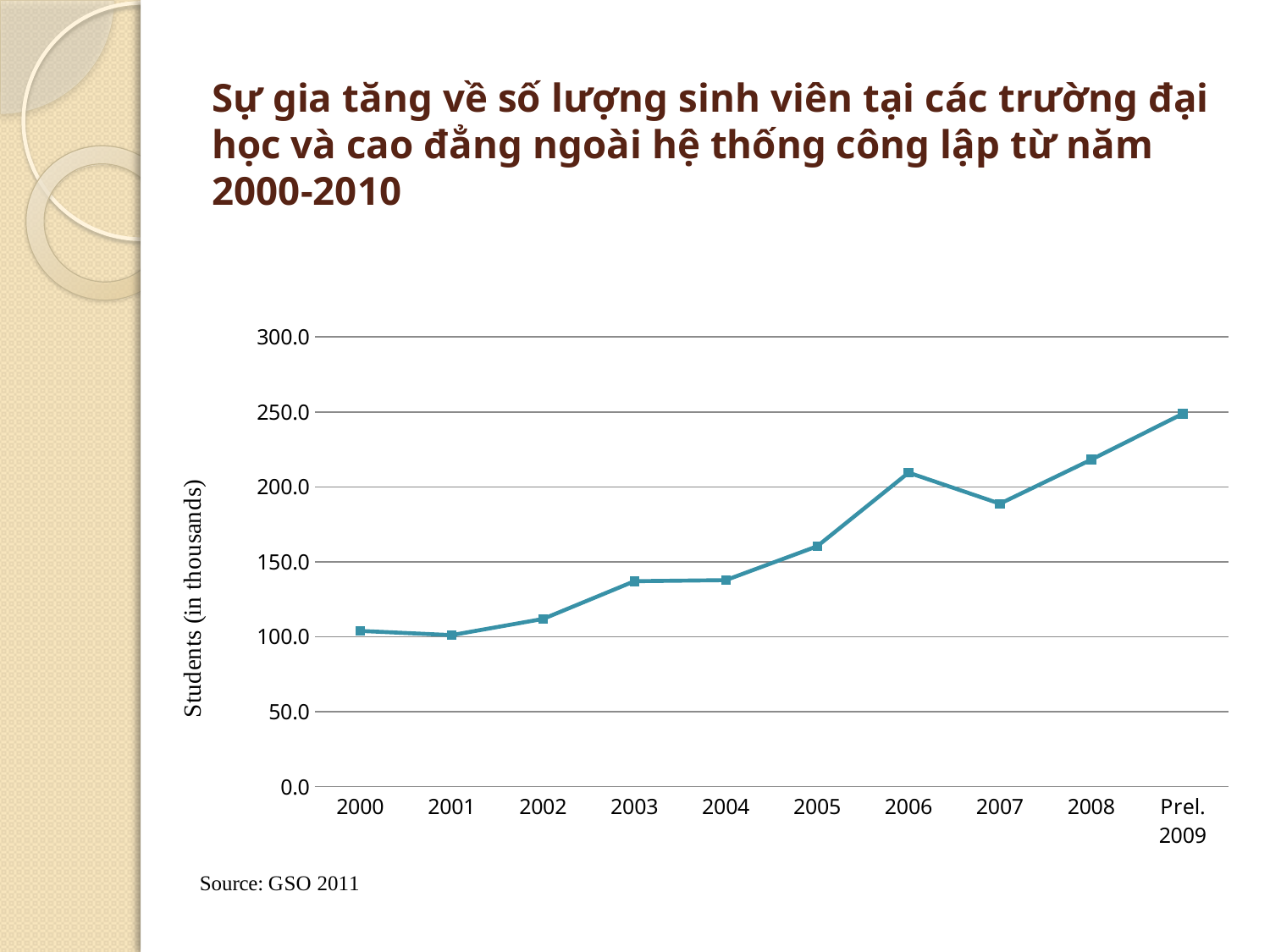
Which is larger, the value for 2006 or the value for 2007? 2006 How many data points are plotted on the line? 10 Which year has the highest number of students? Prel. 2009 Overall, do the values rise or fall from 2000 to Prel. 2009? rise Is the value for 2003 greater or less than 150.0? less Is the value for 2005 greater or less than 150.0? greater What kind of chart is shown on the slide? line chart Which is larger, the value for 2004 or the value for 2005? 2005 Is the value for 2002 greater or less than 100.0? greater What is the label on the vertical axis? Students (in thousands)